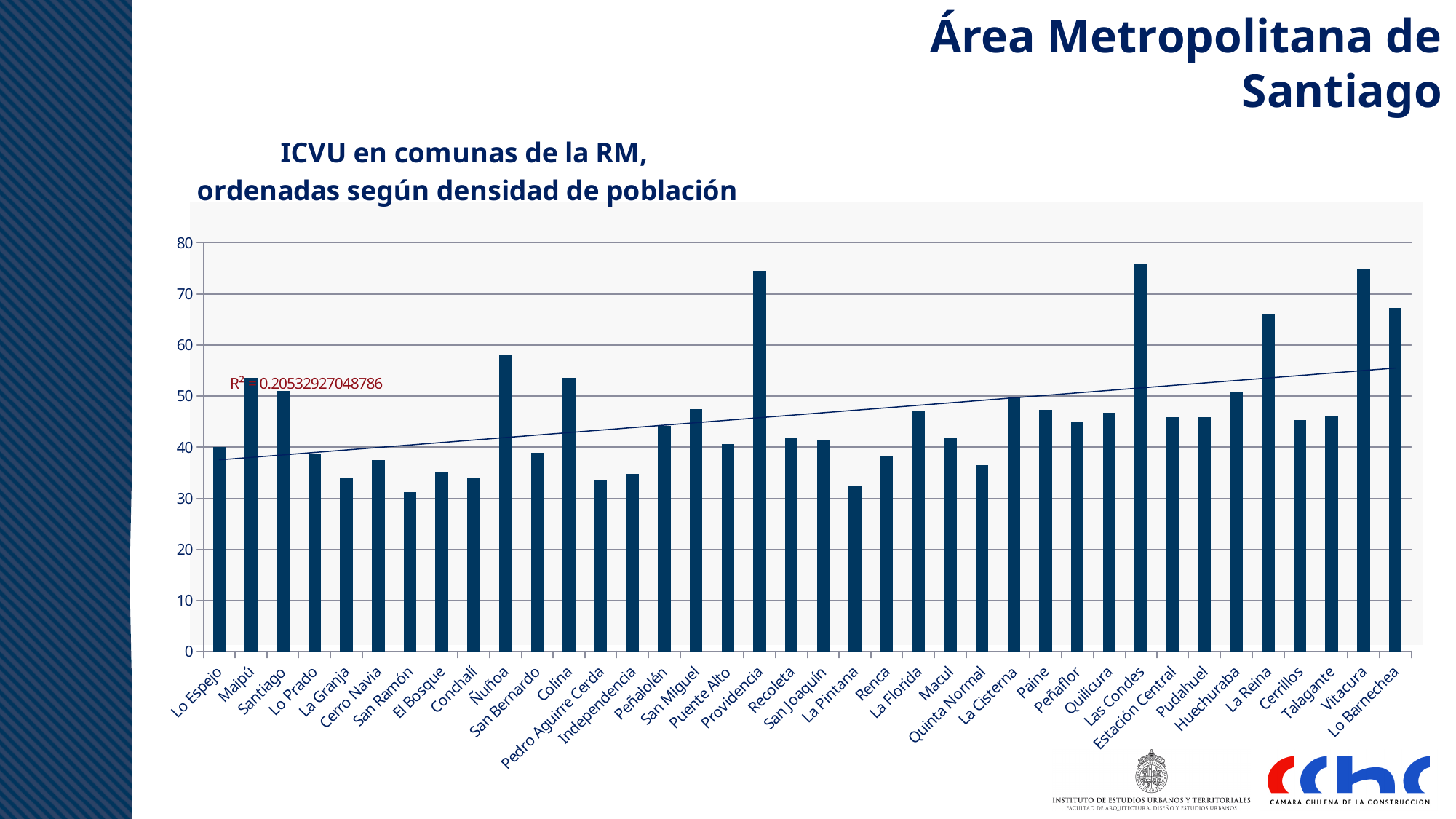
Is the value for Providencia greater or less than 70? greater Which has the larger value, Ñuñoa or Colina? Ñuñoa Is the value for Ñuñoa greater or less than 50? greater Which has the larger value, Las Condes or Maipú? Las Condes How many comunas (categories) are plotted on the x axis of the chart? 38 Is the value for San Ramón greater or less than 40? less What is the title of the chart? ICVU en comunas de la RM, ordenadas según densidad de población What R² value is printed on the chart? R² = 0.20532927048786 What kind of chart is shown on the slide? bar chart Does the trend line drawn across the chart rise or fall from left to right? rise